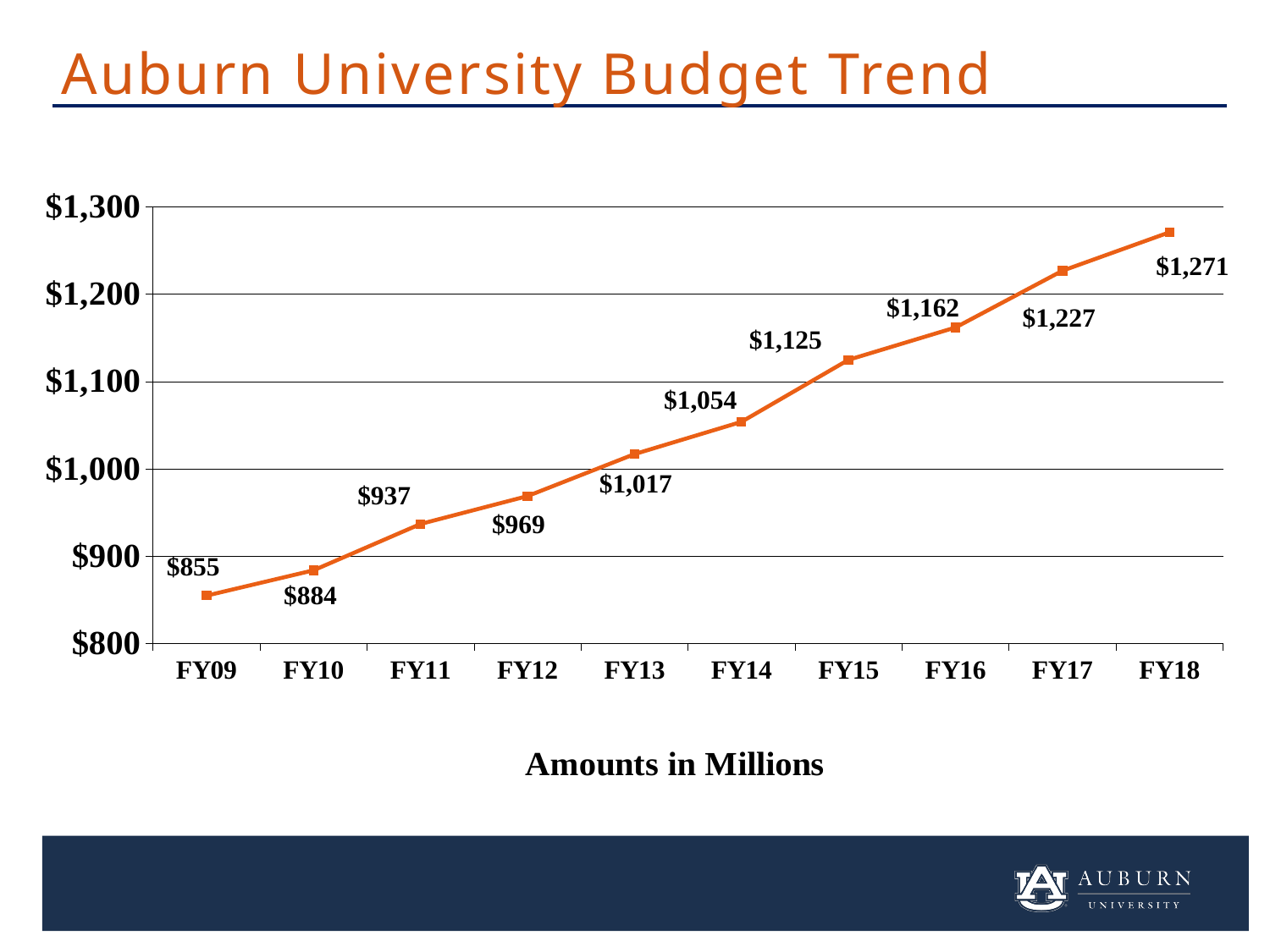
What is the budget value for FY09? $855 Which fiscal year has the highest budget value? FY18 What is the budget value for FY16? $1,162 Which fiscal year has the lowest budget value? FY09 What is the difference between the FY18 and FY09 budget values? $416 What is the difference between the FY15 and FY14 budget values? $71 What is the budget value for FY13? $1,017 Which is larger, the budget value for FY11 or FY12? FY12 Do the budget values rise or fall from FY09 to FY18? rise Is the value for FY12 greater or less than $1,000? less How many fiscal years are plotted on the chart? 10 What kind of chart is shown on the slide? line chart